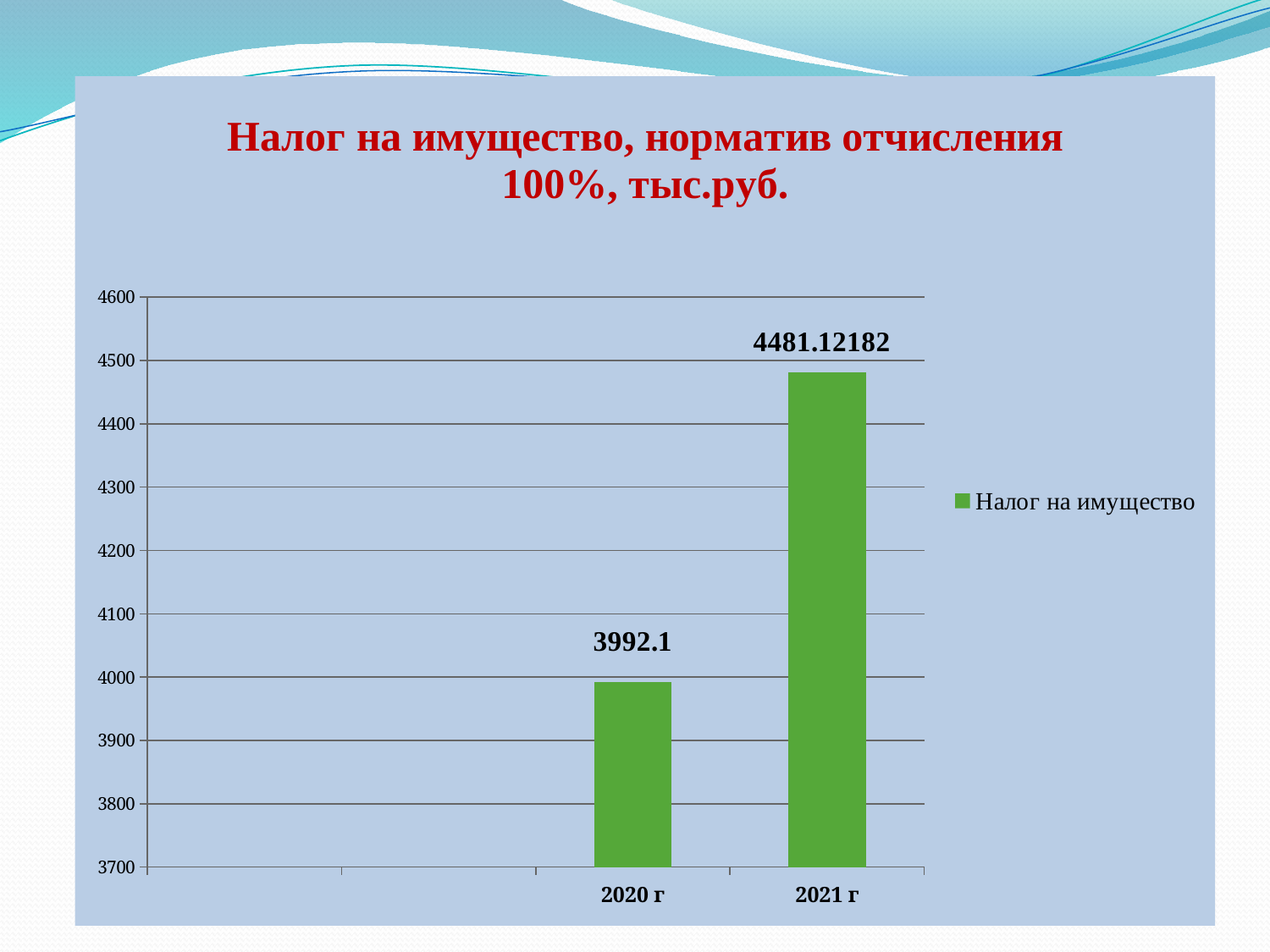
Which is larger, the value for 2020 г or the value for 2021 г? 2021 г Do the values rise or fall from 2020 г to 2021 г? rise What is the value for 2020 г? 3992.1 Is the value for 2021 г greater or less than 4400? greater Which year has the lowest value? 2020 г How many series does the legend list? 1 Is the value for 2020 г greater or less than 4000? less What kind of chart is shown on the slide? bar chart What is the value for 2021 г? 4481.12182 Which year has the highest value? 2021 г What is the difference between the values for 2021 г and 2020 г? 489.02182 How many years are shown on the chart? 2